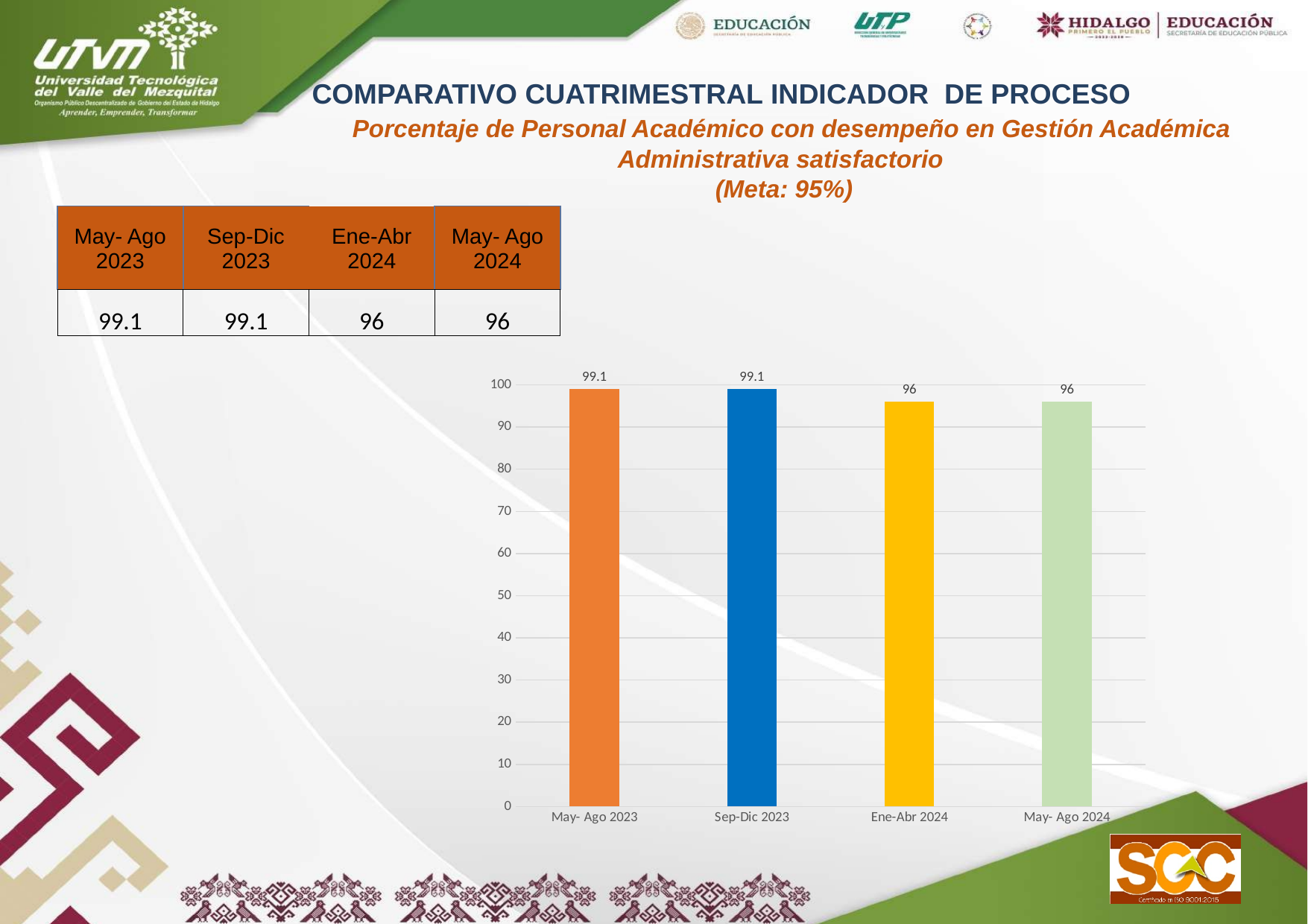
What kind of chart is shown on the slide? bar chart Which is larger, the value for May- Ago 2023 or the value for May- Ago 2024? May- Ago 2023 What colour is the bar for Sep-Dic 2023? blue Is the value for Ene-Abr 2024 greater or less than 90? greater Do the values rise or fall from May- Ago 2023 to May- Ago 2024? fall How many categories are shown on the x axis of the chart? 4 What is the value for May- Ago 2023? 99.1 What is the value for Ene-Abr 2024? 96 What is the target (Meta) stated in the chart's subtitle? 95% What is the value for May- Ago 2024? 96 What is the value for Sep-Dic 2023? 99.1 What is the difference between the value for Sep-Dic 2023 and the value for Ene-Abr 2024? 3.1